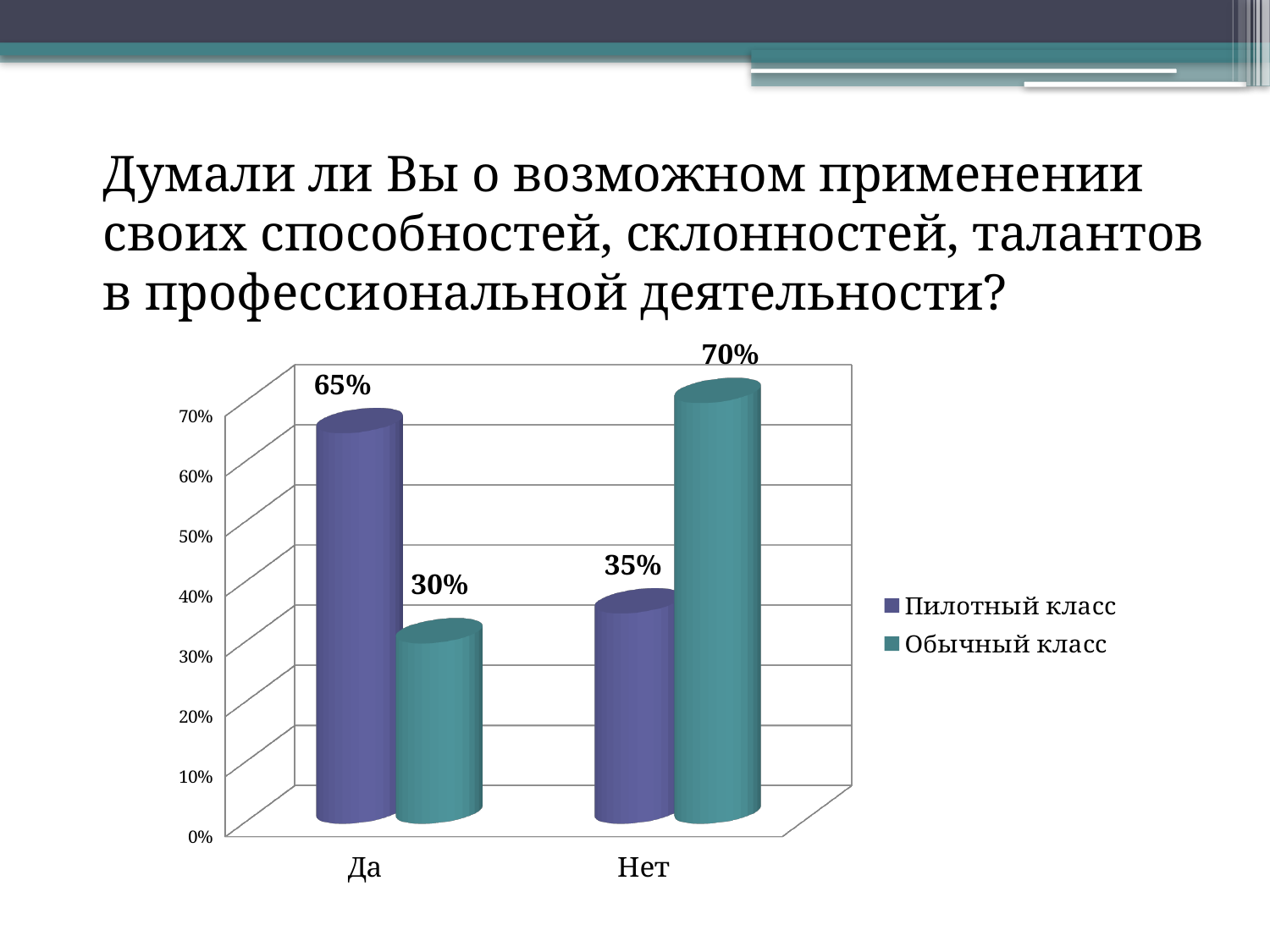
Which series is shown in purple in the legend? Пилотный класс What is the value for Пилотный класс in the Да category? 65% What is the value for Пилотный класс in the Нет category? 35% What kind of chart is shown on the slide? Bar chart How many series does the legend list? 2 What is the value for Обычный класс in the Да category? 30% How many categories are shown on the x axis? 2 What is the difference between Пилотный класс and Обычный класс in the Да category? 35% Which is larger in the Нет category: Пилотный класс or Обычный класс? Обычный класс Which category has the lowest value for Пилотный класс? Нет What is the value for Обычный класс in the Нет category? 70% Which category has the highest value for Обычный класс? Нет